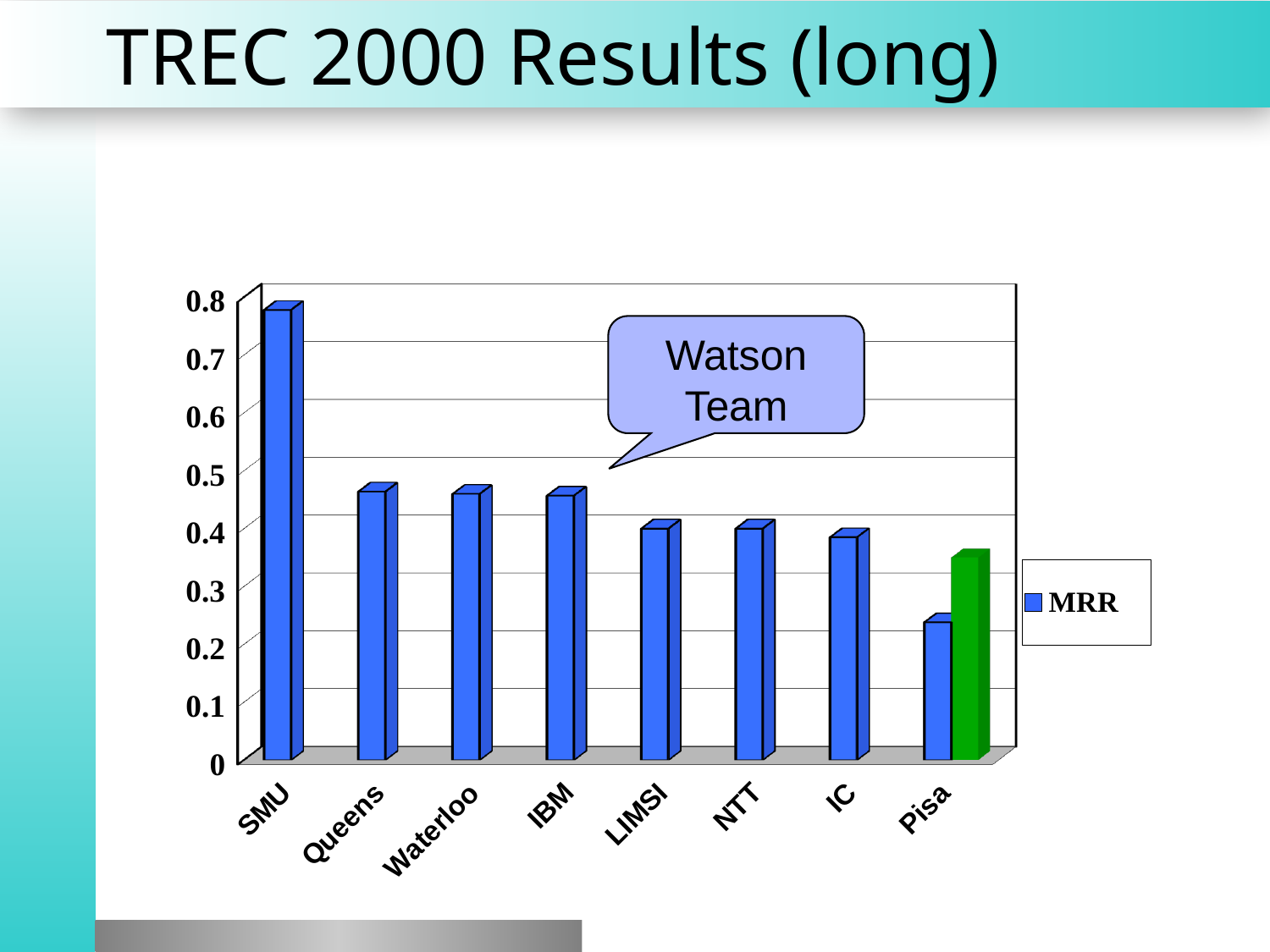
How many series does the legend list? 1 Is the blue MRR bar for Pisa greater or less than 0.3? less Is the MRR value for SMU greater or less than 0.7? greater Is the MRR value for Queens greater or less than 0.5? less What kind of chart is shown on the slide? bar chart How many categories are shown on the x axis? 8 Which category has the lowest blue MRR bar? Pisa Which category has the highest MRR value? SMU Do the MRR values generally rise or fall from left to right along the x axis? fall Which category does the 'Watson Team' callout point to? IBM Which has a higher MRR value, SMU or Queens? SMU